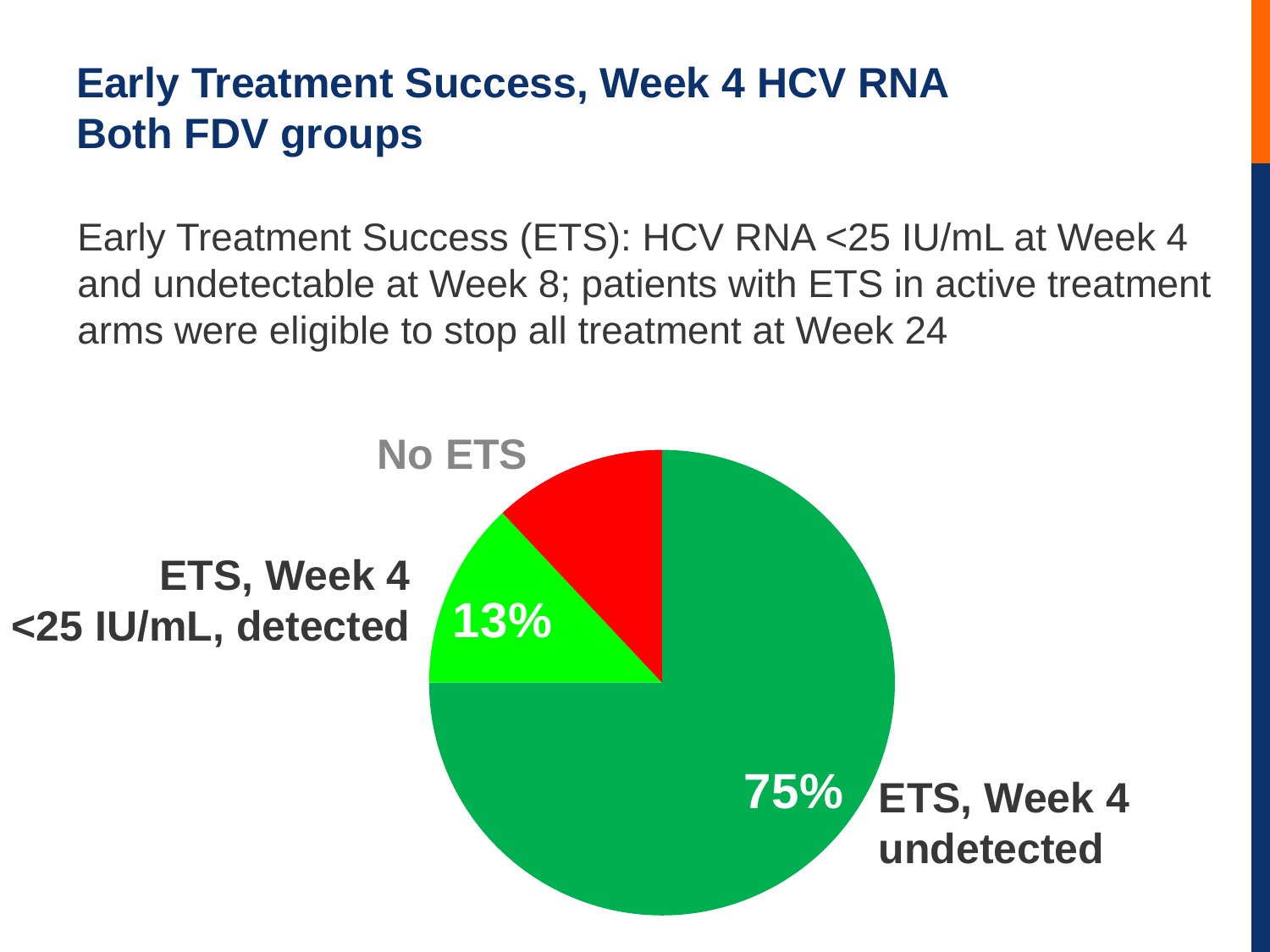
Which is larger: the 'ETS, Week 4 undetected' slice or the 'No ETS' slice? ETS, Week 4 undetected What colour is the 'No ETS' slice? red How many slices does the pie chart have? 3 What kind of chart is shown on the slide? pie chart What is the difference in percentage points between the 'ETS, Week 4 undetected' slice and the 'ETS, Week 4 <25 IU/mL, detected' slice? 62 percentage points Is the share for 'ETS, Week 4 undetected' greater or less than 50%? greater Which slice is shown in dark green? ETS, Week 4 undetected What percentage of patients had ETS with Week 4 HCV RNA <25 IU/mL, detected? 13% What percentage of patients had ETS with Week 4 HCV RNA undetected? 75% Is the share for 'No ETS' greater or less than 25%? less Which category has the largest slice of the pie? ETS, Week 4 undetected